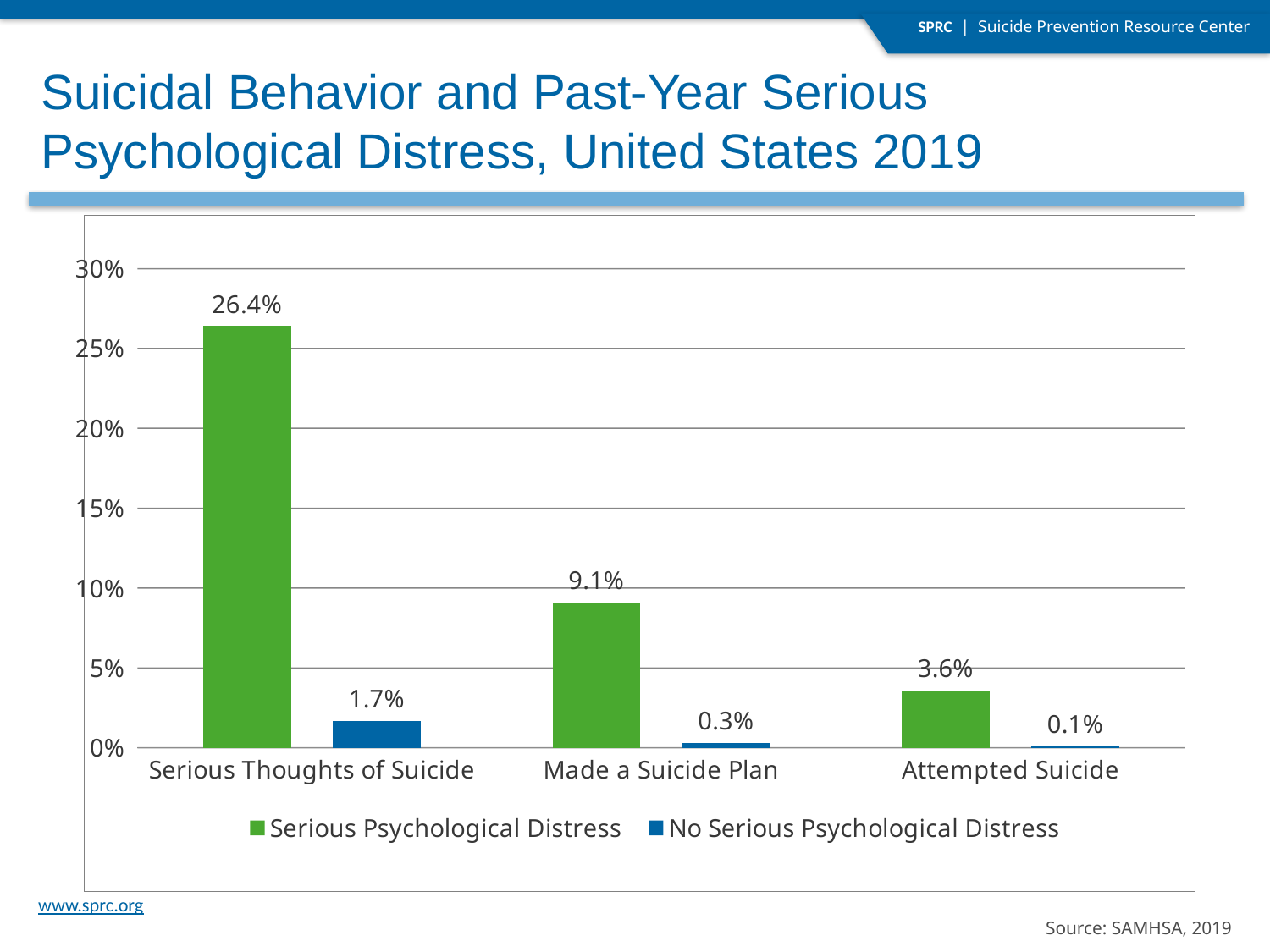
What colour represents the No Serious Psychological Distress series? Blue What is the value for No Serious Psychological Distress in the Attempted Suicide category? 0.1% How many series does the legend list? 2 Which category has the lowest value for No Serious Psychological Distress? Attempted Suicide What is the difference between the Serious Psychological Distress and No Serious Psychological Distress values for Serious Thoughts of Suicide? 24.7% What is the value for Serious Psychological Distress in the Attempted Suicide category? 3.6% What kind of chart is shown on the slide? Bar chart Which is larger: the Serious Psychological Distress value for Made a Suicide Plan or for Attempted Suicide? Made a Suicide Plan What is the value for Serious Psychological Distress in the Serious Thoughts of Suicide category? 26.4% What is the value for No Serious Psychological Distress in the Made a Suicide Plan category? 0.3% How many categories are shown on the x axis? 3 Which category has the highest value for Serious Psychological Distress? Serious Thoughts of Suicide